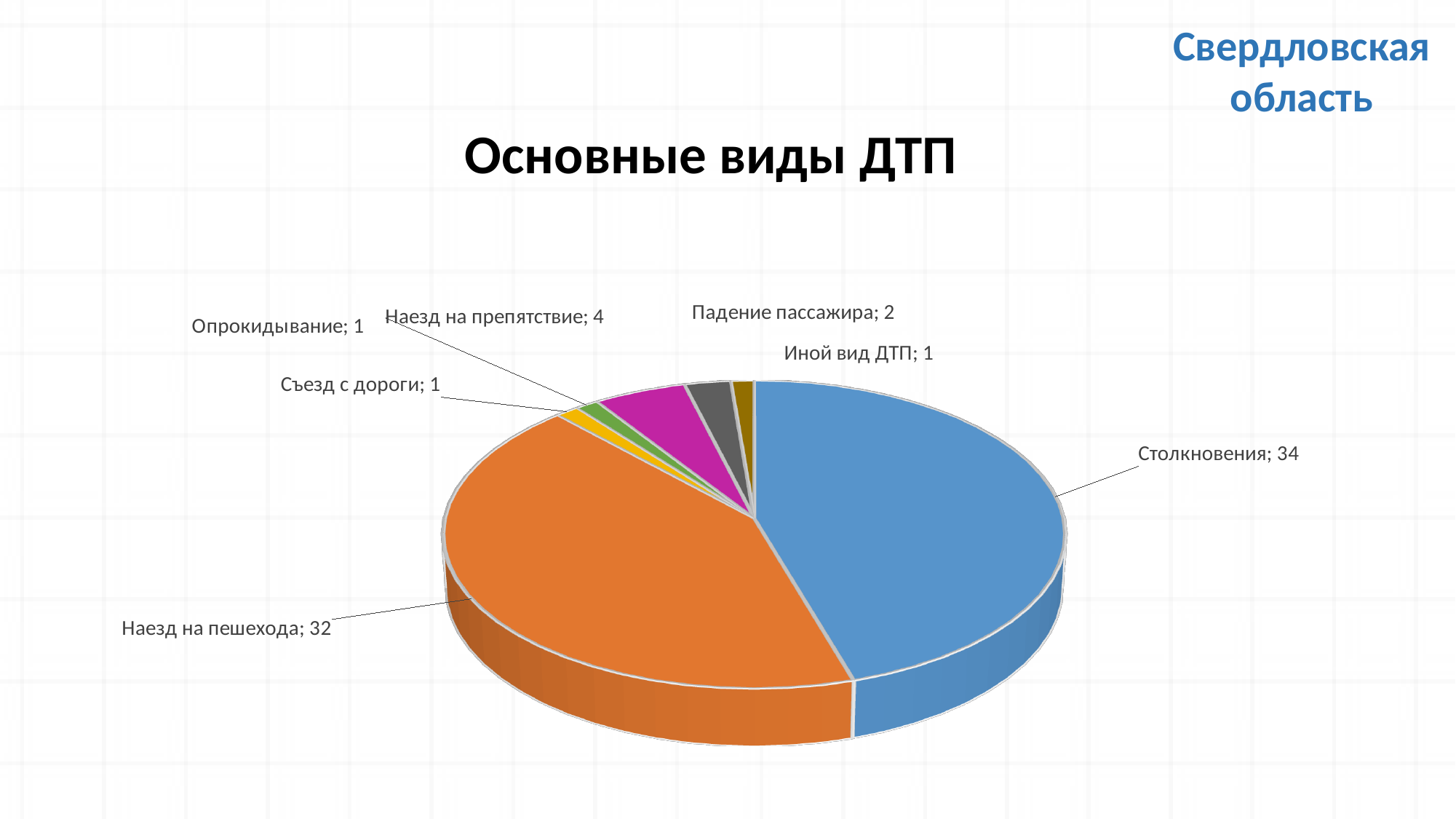
What is the difference between the values for Столкновения and Наезд на пешехода? 2 Which is larger, the value for Наезд на препятствие or the value for Падение пассажира? Наезд на препятствие What is the total of all the values shown in the pie chart? 75 Which category has the highest value? Столкновения What type of chart is shown on the slide? Pie chart What is the value for Наезд на препятствие? 4 What is the value for Столкновения? 34 How many categories (slices) does the pie chart have? 7 What is the value for Падение пассажира? 2 What is the title of the chart? Основные виды ДТП What colour is the slice for Наезд на пешехода? Orange What is the value for Наезд на пешехода? 32